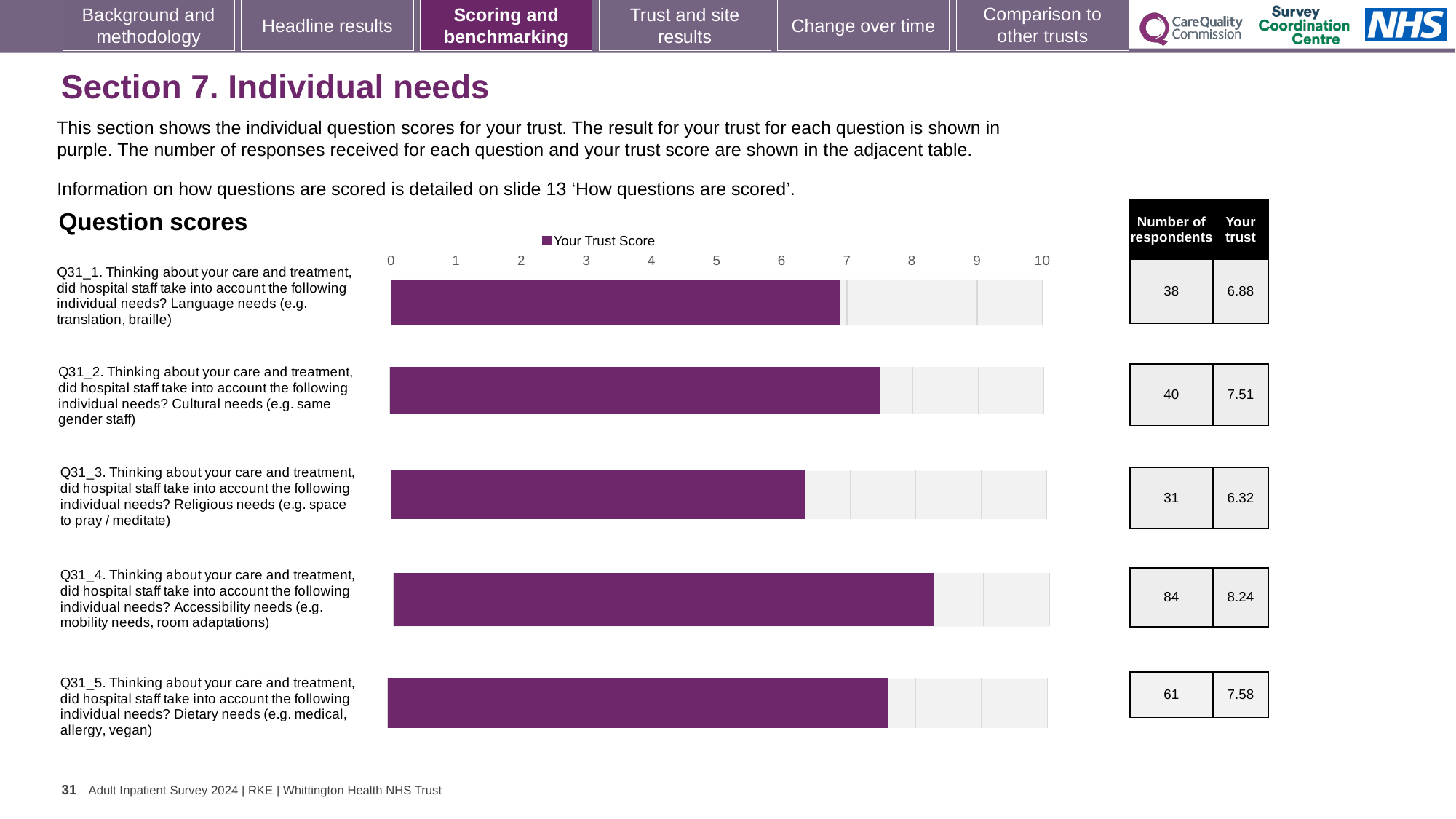
How many series does the chart legend list? 1 How many respondents answered Q31_5 (Dietary needs)? 61 What type of chart is shown on the slide? Bar chart Is the trust score for Q31_1 (Language needs) greater or less than 7? less What is the name of the series shown in the chart legend? Your Trust Score What is the trust score for Q31_4 (Accessibility needs)? 8.24 Which question has the highest trust score? Q31_4 (Accessibility needs) Which question has the lowest trust score? Q31_3 (Religious needs) What is the trust score for Q31_3 (Religious needs)? 6.32 How many questions are plotted in the chart? 5 What is the difference between the trust scores for Q31_4 and Q31_3? 1.92 Which has a higher trust score, Q31_1 (Language needs) or Q31_2 (Cultural needs)? Q31_2 (Cultural needs)